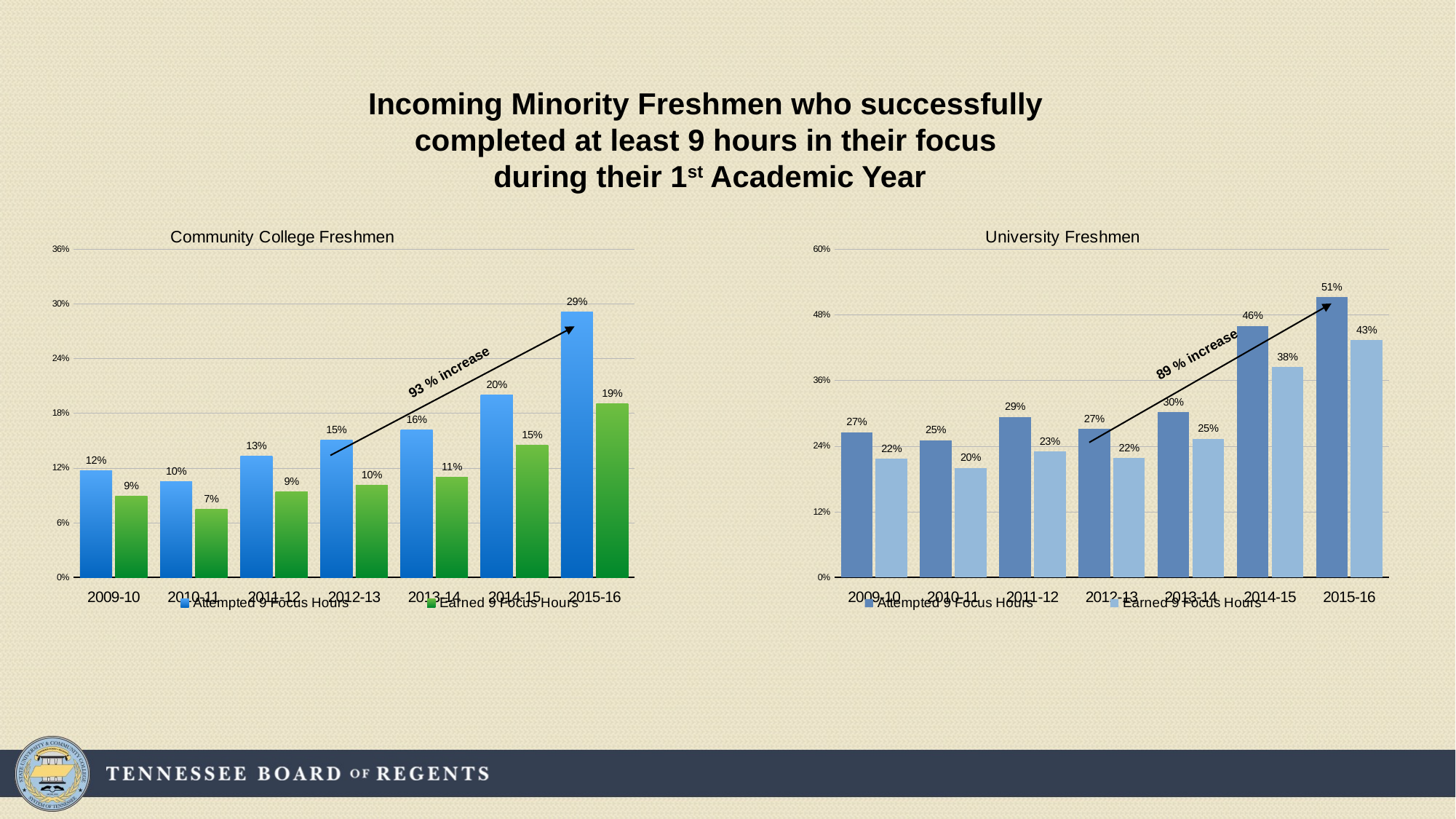
What percentage increase is annotated with an arrow on the Community College Freshmen chart? 93 % increase What type of chart is the University Freshmen chart? Bar chart In the Community College Freshmen chart, which is larger in 2014-15: Attempted 9 Focus Hours or Earned 9 Focus Hours? Attempted 9 Focus Hours In the Community College Freshmen chart, what is the value for Earned 9 Focus Hours in 2010-11? 7% In the University Freshmen chart, what is the value for Earned 9 Focus Hours in 2014-15? 38% In the University Freshmen chart, which year has the highest value for Attempted 9 Focus Hours? 2015-16 In the University Freshmen chart, what is the difference between Attempted 9 Focus Hours and Earned 9 Focus Hours in 2015-16? 8% In the Community College Freshmen chart, what is the value for Attempted 9 Focus Hours in 2015-16? 29% How many academic years are shown on the x axis of the Community College Freshmen chart? 7 How many series does the legend of the University Freshmen chart list? 2 In the University Freshmen chart, is the value for Attempted 9 Focus Hours in 2014-15 greater or less than 36%? greater In the Community College Freshmen chart, which year has the lowest value for Earned 9 Focus Hours? 2010-11